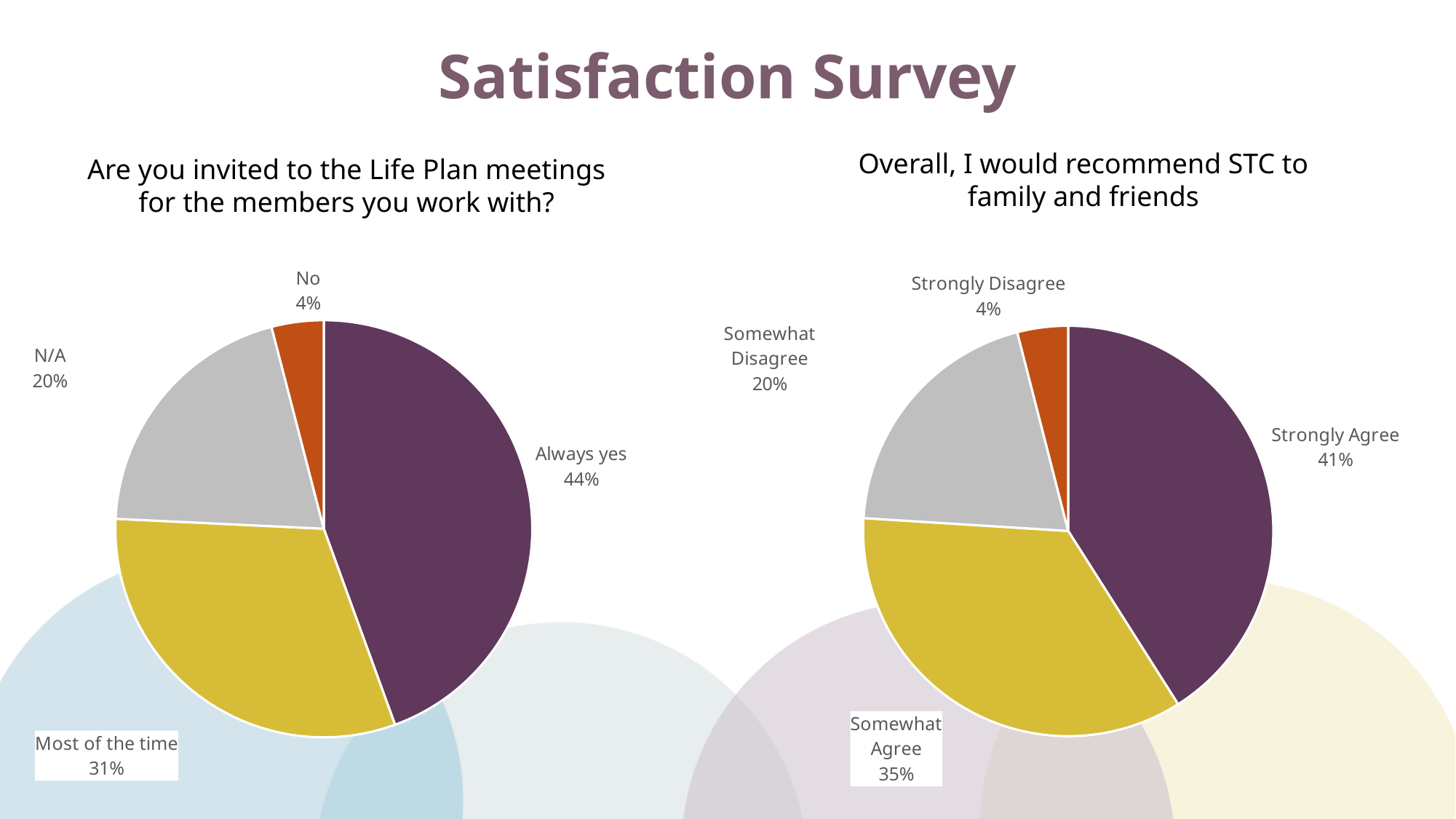
In the left pie chart ('Are you invited to the Life Plan meetings...'), which category has the smallest share? No In the left pie chart ('Are you invited to the Life Plan meetings...'), which category has the largest share? Always yes In the right pie chart ('Overall, I would recommend STC to family and friends'), what percentage is 'Strongly Agree'? 41% In the left pie chart ('Are you invited to the Life Plan meetings...'), what percentage is 'Most of the time'? 31% In the right pie chart ('Overall, I would recommend STC to family and friends'), what is the difference between 'Somewhat Agree' and 'Strongly Disagree'? 31% In the left pie chart ('Are you invited to the Life Plan meetings...'), what is the difference between 'Always yes' and 'Most of the time'? 13% In the left pie chart ('Are you invited to the Life Plan meetings for the members you work with?'), what percentage is 'Always yes'? 44% In the left pie chart ('Are you invited to the Life Plan meetings...'), how many categories are shown? 4 What type of chart is used for 'Overall, I would recommend STC to family and friends'? Pie chart In the right pie chart ('Overall, I would recommend STC to family and friends'), which is larger: 'Strongly Agree' or 'Somewhat Agree'? Strongly Agree In the right pie chart ('Overall, I would recommend STC to family and friends'), what percentage is 'Somewhat Disagree'? 20% What is the title of the slide? Satisfaction Survey